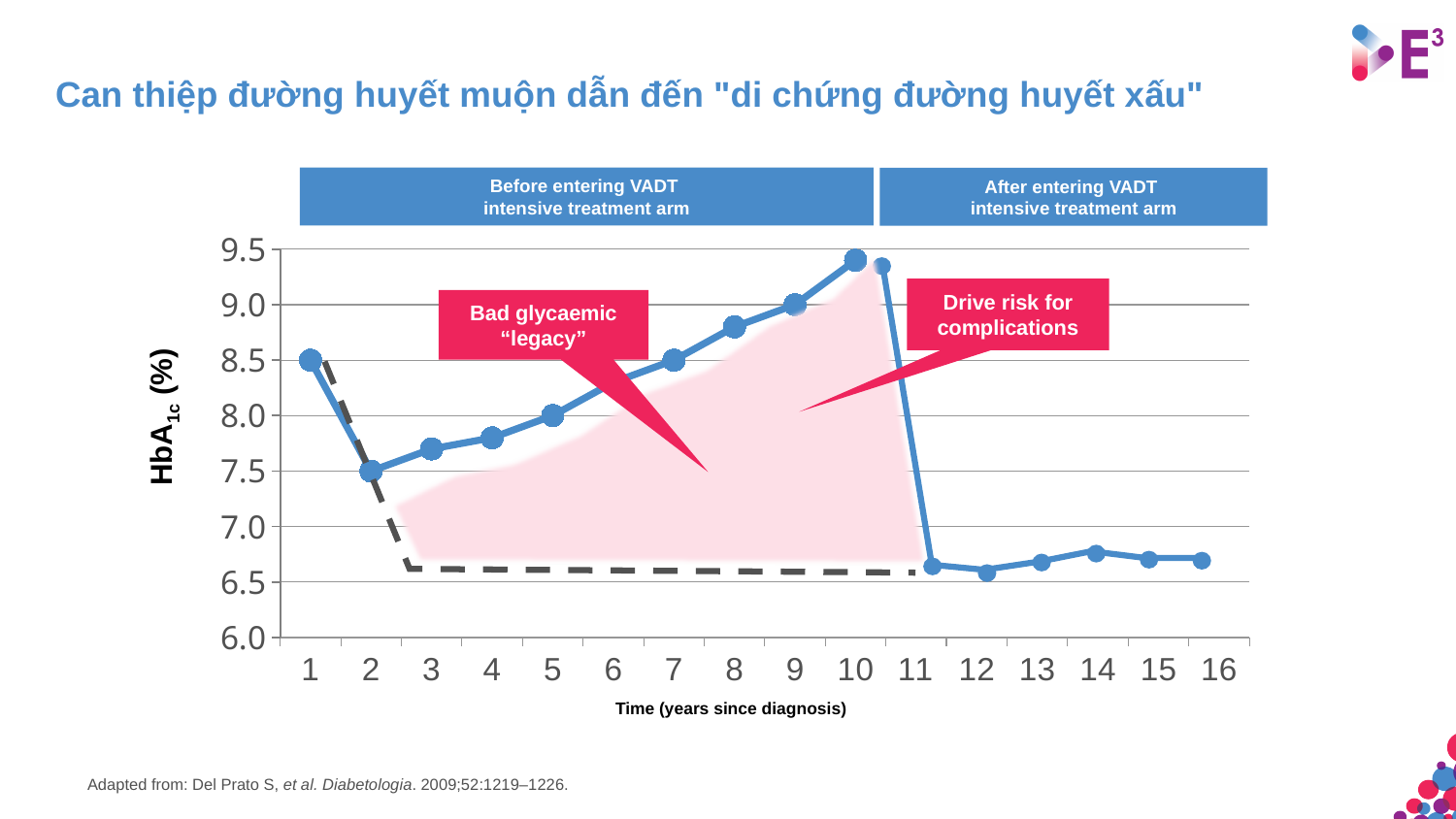
What is the HbA1c value at year 2 since diagnosis? 7.5 What type of chart is shown on the slide? Line chart What is the HbA1c value at year 9 since diagnosis? 9.0 Is the HbA1c value at year 12 greater or less than 7.0? less What is the label of the x axis? Time (years since diagnosis) Between year 2 and year 10, does the HbA1c value rise or fall? Rise Is the HbA1c value at year 3 greater or less than 8.0? less What is the label of the y axis? HbA1c (%) At which year since diagnosis does HbA1c reach its highest value? 10 What is the HbA1c value at year 1 since diagnosis? 8.5 Which has the higher HbA1c value: year 2 or year 9? Year 9 Is the HbA1c value at year 10 greater or less than 9.0? greater